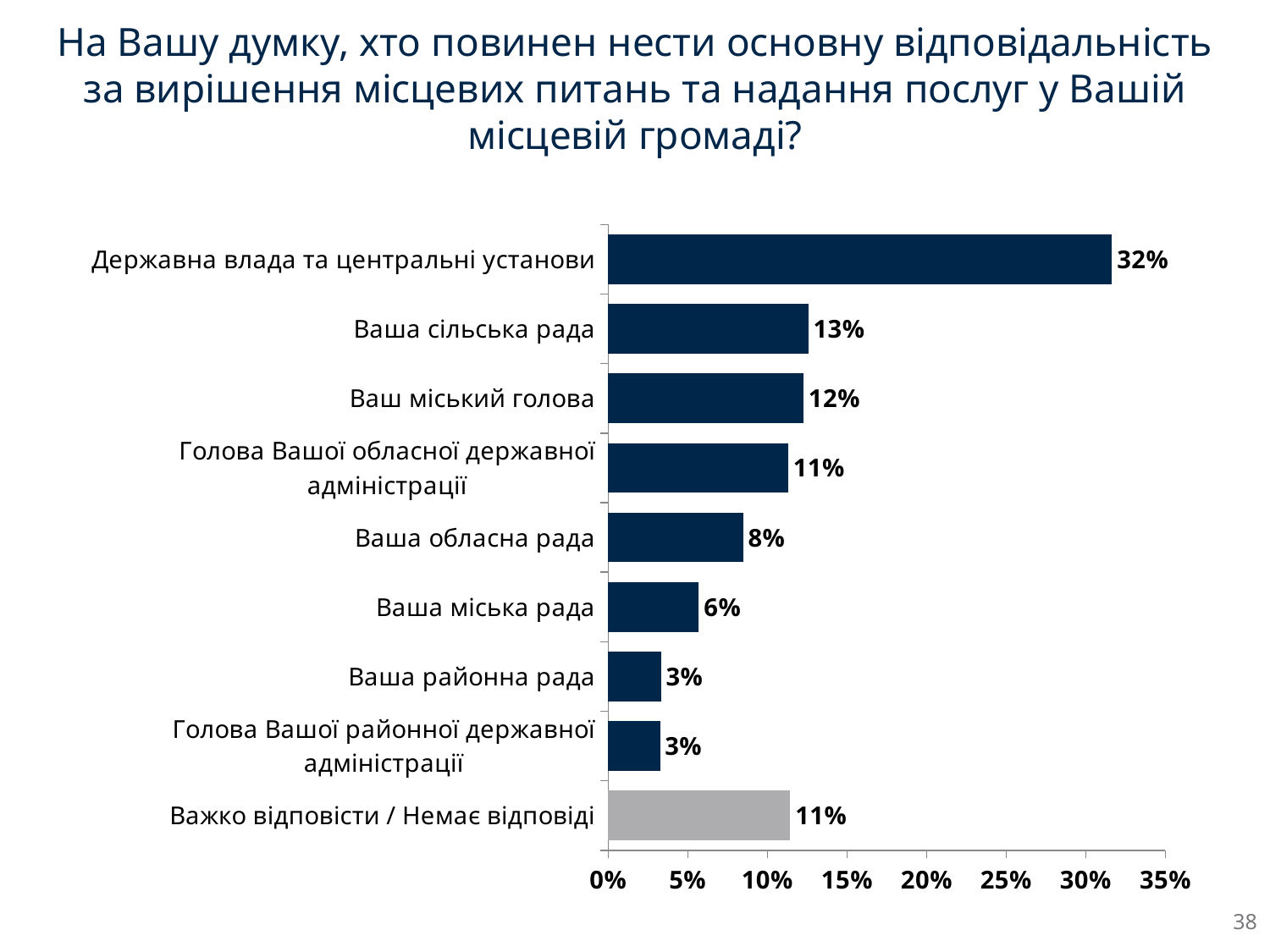
What value is shown for "Державна влада та центральні установи"? 32% Is the value for "Голова Вашої обласної державної адміністрації" greater or less than 10%? greater What value is shown for "Ваша сільська рада"? 13% Which category's bar is coloured grey instead of dark blue? Важко відповісти / Немає відповіді What kind of chart is shown on the slide? bar chart What value is shown for "Важко відповісти / Немає відповіді"? 11% Which is larger, the value for "Ваша сільська рада" or the value for "Ваша обласна рада"? Ваша сільська рада How many categories are shown in the chart? 9 What is the difference between the values for "Державна влада та центральні установи" and "Ваша сільська рада"? 19% Which category has the highest value? Державна влада та центральні установи What value is shown for "Ваша обласна рада"? 8% What is the difference between the values for "Ваш міський голова" and "Ваша міська рада"? 6%